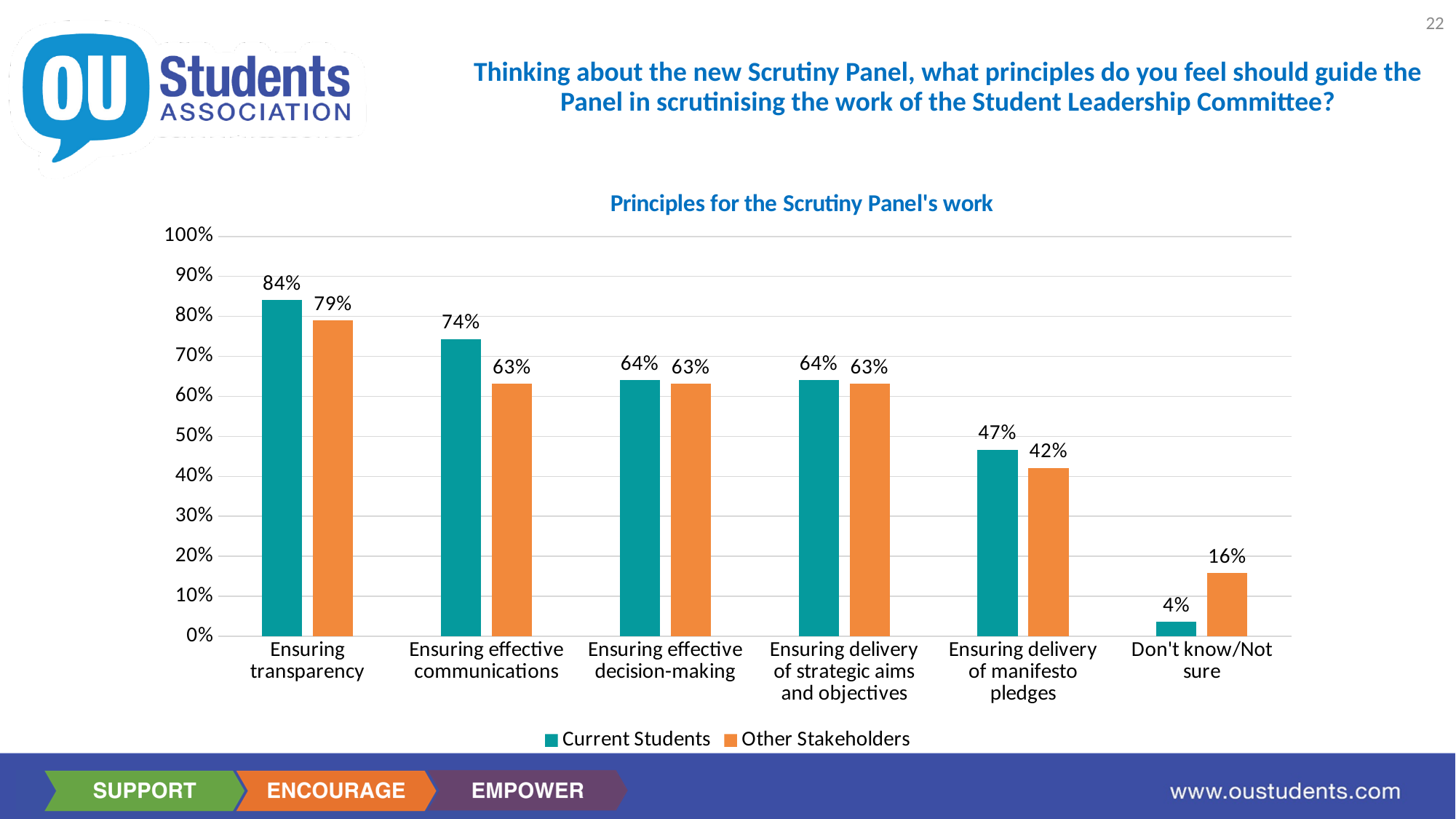
What is the value for Other Stakeholders for Don't know/Not sure? 16% What is the value for Other Stakeholders for Ensuring delivery of manifesto pledges? 42% Which category has the lowest value for Other Stakeholders? Don't know/Not sure What is the title of the chart? Principles for the Scrutiny Panel's work What kind of chart is shown? bar chart What is the difference between Current Students and Other Stakeholders for Ensuring effective communications? 11% What is the value for Current Students for Ensuring transparency? 84% How many series does the legend list? 2 Is the value for Current Students for Ensuring delivery of manifesto pledges greater or less than 40%? greater How many categories are shown on the x axis? 6 Which is larger for Don't know/Not sure: Current Students or Other Stakeholders? Other Stakeholders Which category has the highest value for Current Students? Ensuring transparency